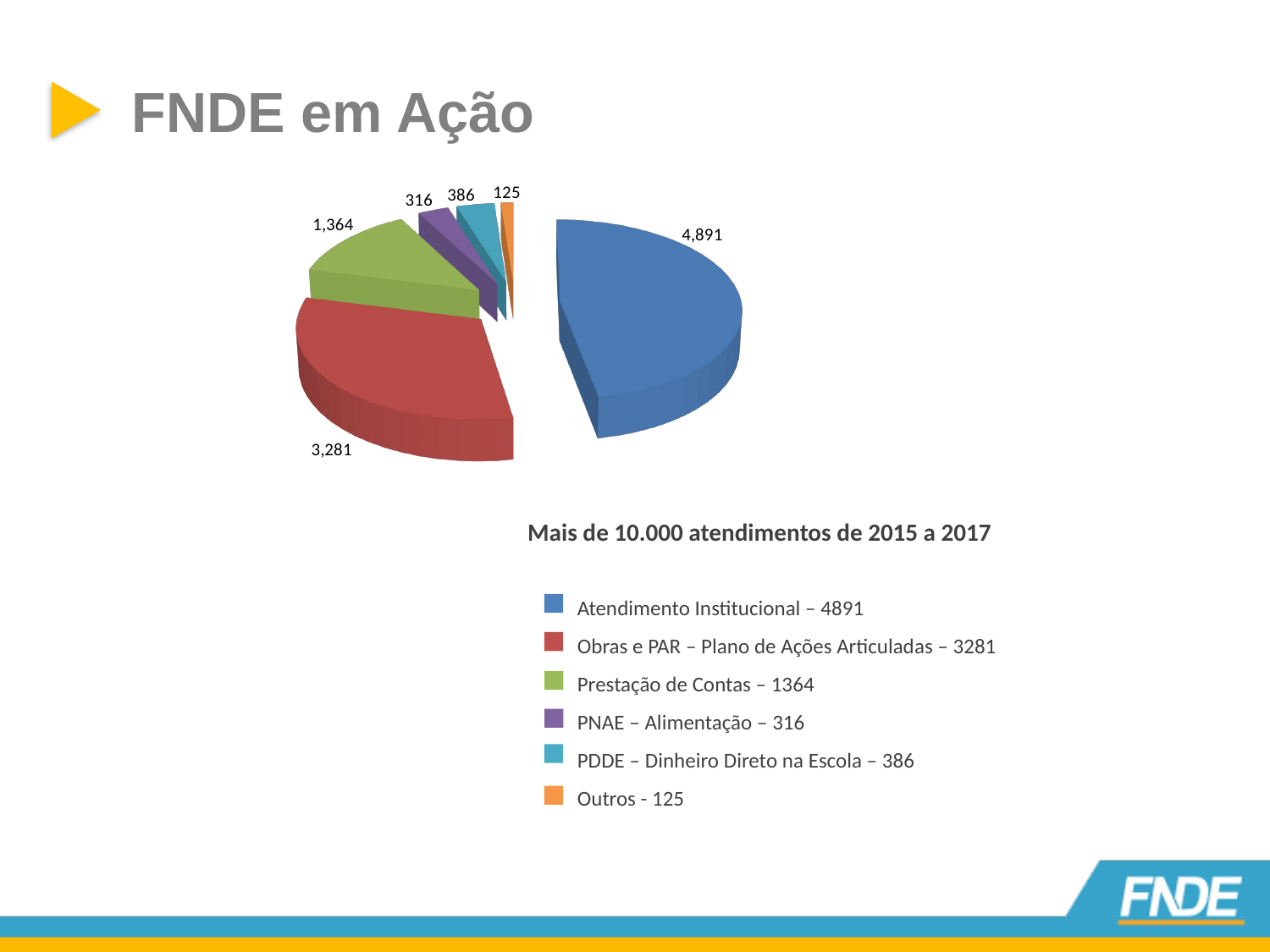
Which is larger, the PNAE – Alimentação slice or the PDDE – Dinheiro Direto na Escola slice? PDDE – Dinheiro Direto na Escola What is the value of the Prestação de Contas slice? 1,364 What kind of chart is shown on the slide? pie chart What is the difference between the PDDE value and the PNAE value? 70 What is the value of the Atendimento Institucional slice? 4,891 Which category has the largest slice of the pie? Atendimento Institucional What is the difference between the Atendimento Institucional value and the Obras e PAR value? 1,610 How many slices does the pie chart have? 6 What is the text shown below the pie chart describing the total? Mais de 10.000 atendimentos de 2015 a 2017 Which category has the smallest slice of the pie? Outros What colour is the Obras e PAR – Plano de Ações Articuladas slice? red What is the value of the PDDE – Dinheiro Direto na Escola slice? 386